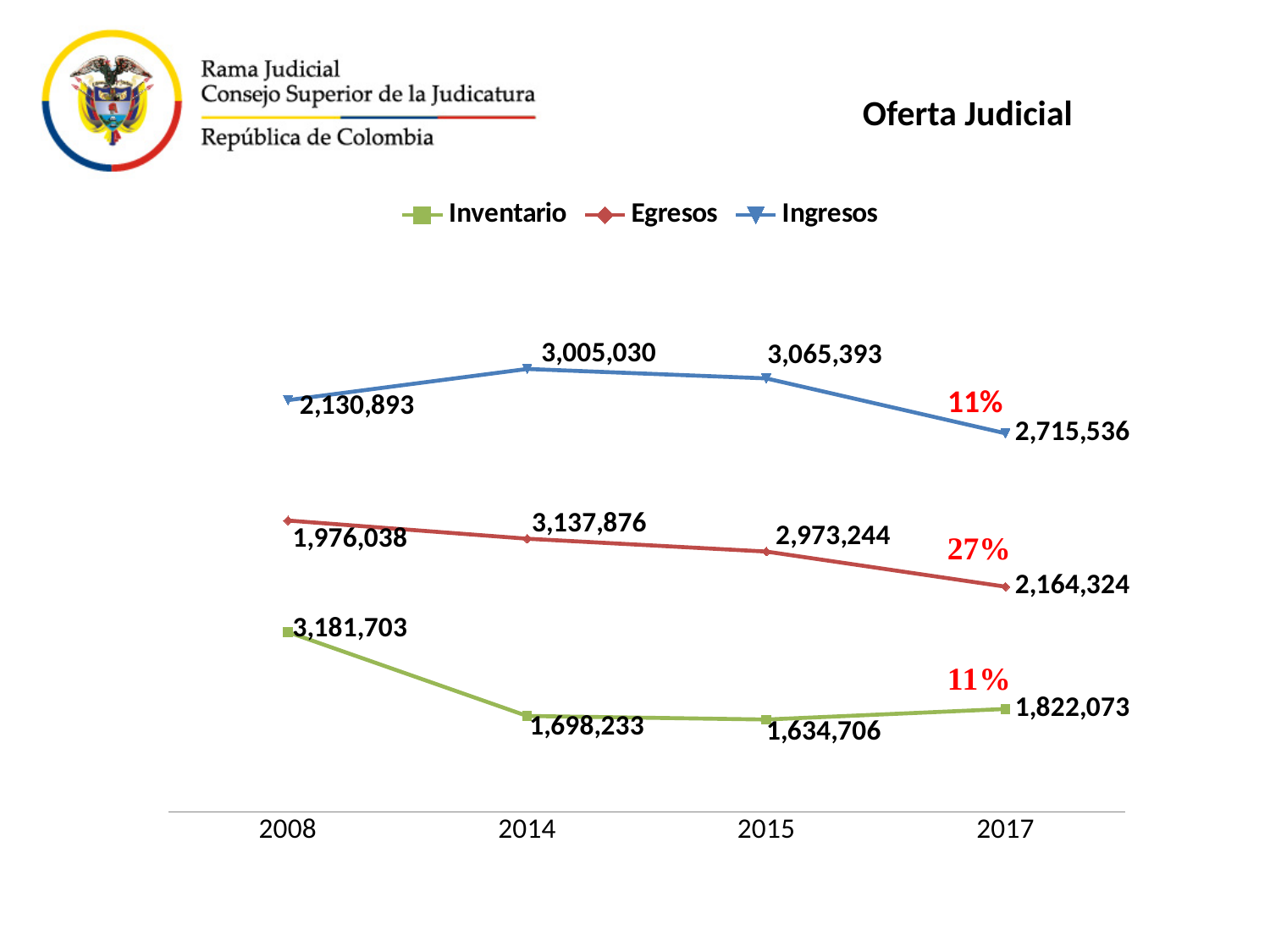
Which is larger in 2014, Egresos or Ingresos? Egresos What is the difference between Inventario in 2008 and Inventario in 2014? 1,483,470 What kind of chart is shown on the slide? Line chart How many series does the legend list? 3 In which year is Egresos highest? 2014 How many years are shown on the x axis? 4 In which year is Inventario lowest? 2015 What is the value of Inventario in 2008? 3,181,703 What is the value of Ingresos in 2015? 3,065,393 What is the difference between Ingresos in 2015 and Ingresos in 2017? 349,857 Does Egresos rise or fall from 2014 to 2017? Fall What is the value of Egresos in 2017? 2,164,324